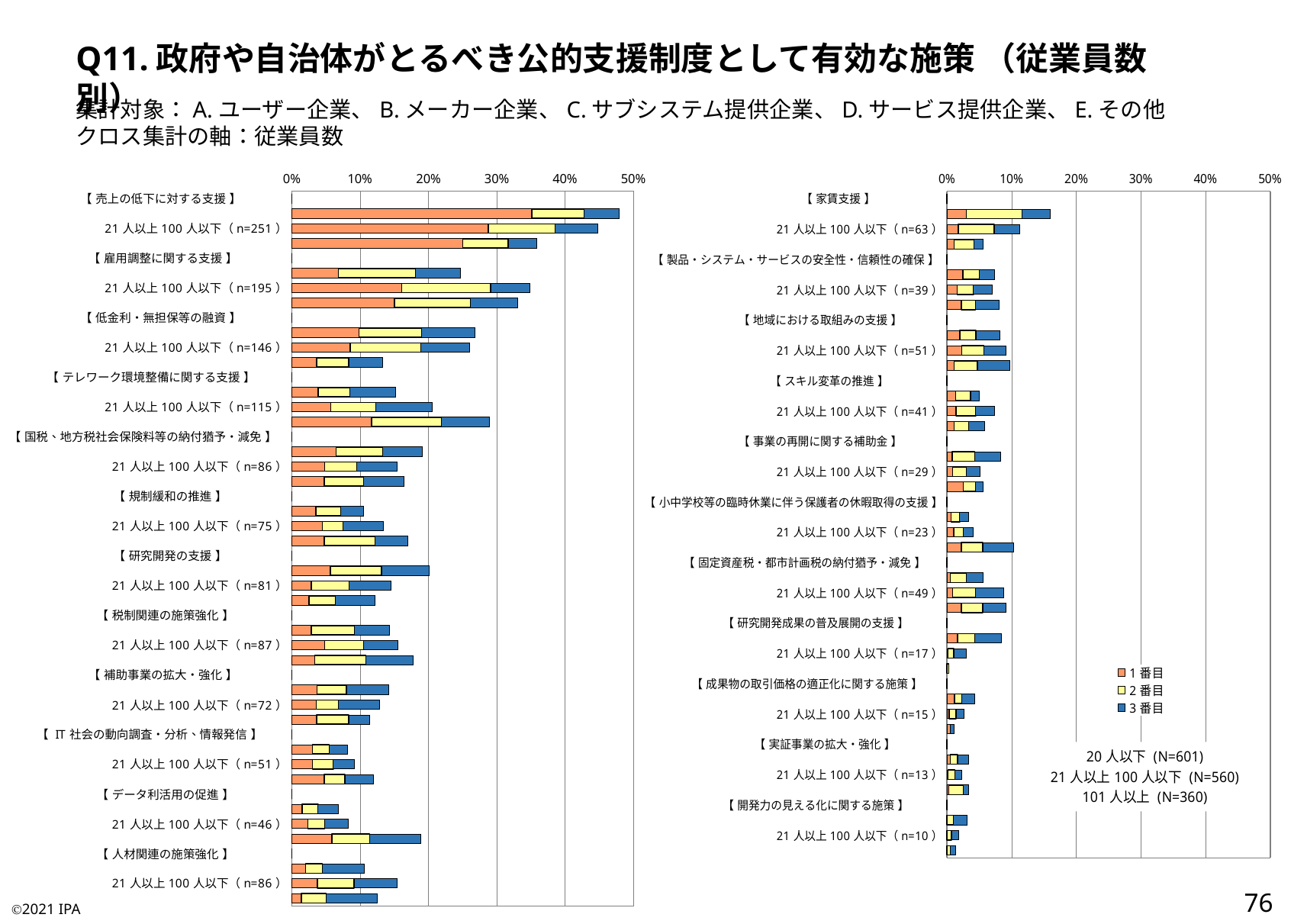
On the right chart, which category has the longest stacked bar? 家賃支援 How many support-measure categories (bold bracketed headings) are shown on the right chart? 11 On the left chart, is the total stacked bar for 売上の低下に対する支援 (20人以下) greater or less than 40%? greater How many series does the legend on the right chart list? 3 On the left chart, is the total stacked bar for 雇用調整に関する支援 (20人以下) greater or less than 20%? greater On the left chart, which category has the longest stacked bar? 売上の低下に対する支援 On the right chart, is the total stacked bar for 家賃支援 (20人以下) greater or less than 10%? greater What are the three legend entries shown on the right chart? 1番目, 2番目, 3番目 How many support-measure categories (bold bracketed headings) are shown on the left chart? 12 What kind of chart is the left chart on the slide? Stacked horizontal bar chart On the left chart, which is larger for the 20人以下 group: the total bar for 売上の低下に対する支援 or for 雇用調整に関する支援? 売上の低下に対する支援